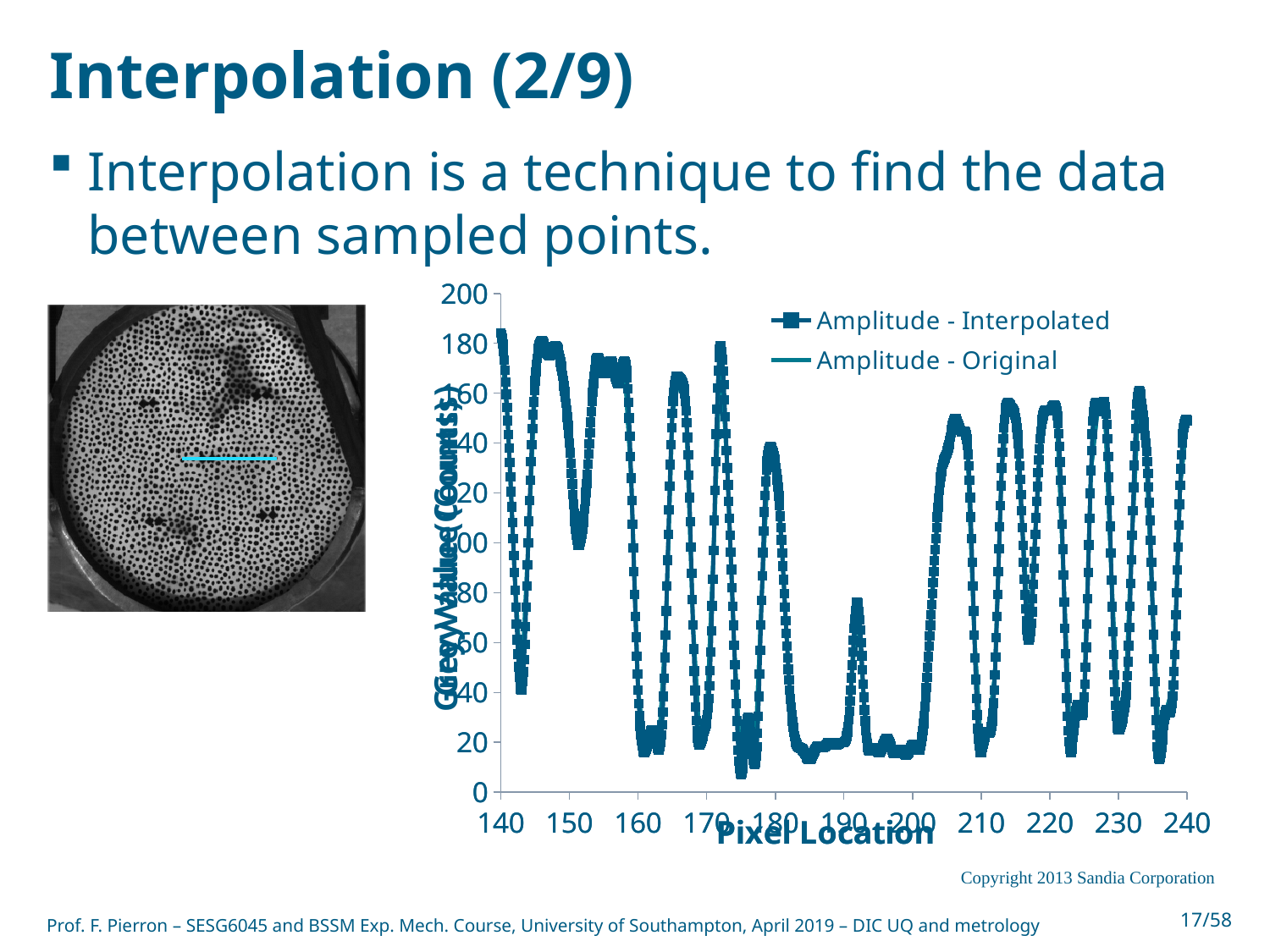
How many series does the chart legend list? 2 Is the amplitude at pixel location 200 greater or less than 40? less Is the amplitude at pixel location 140 greater or less than 160? greater Is the amplitude at pixel location 210 greater or less than 100? less What is the highest pixel location shown on the chart's x axis? 240 What is the label of the chart's x axis? Pixel Location What is the highest value shown on the chart's y axis? 200 What are the two series named in the chart legend? Amplitude - Interpolated; Amplitude - Original What kind of chart is shown on the slide? line chart What is the lowest pixel location shown on the chart's x axis? 140